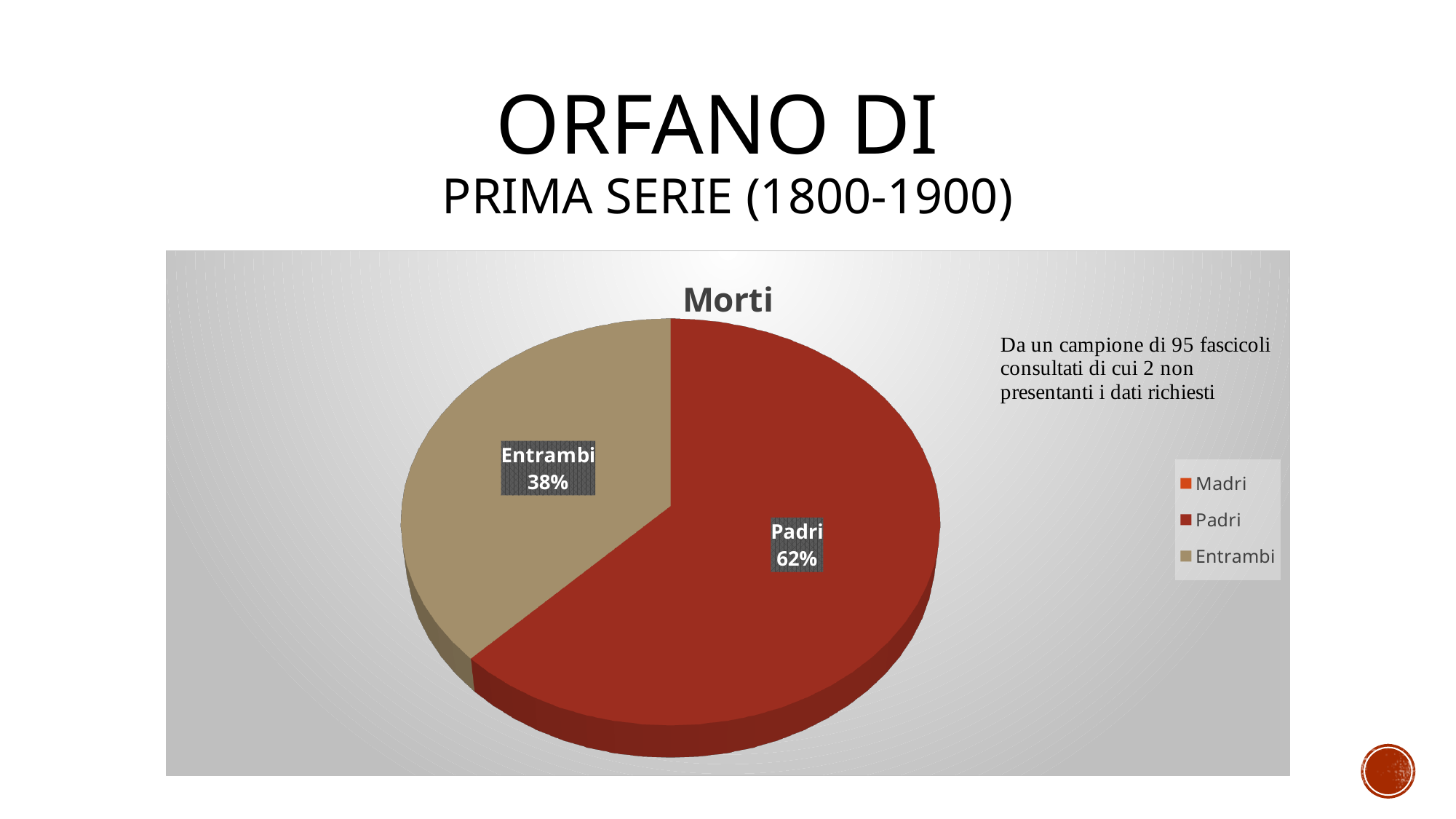
What share of the pie does Entrambi represent? 38% What share of the pie does Padri represent? 62% Which slice of the pie is the largest? Padri Which of the visible slices is the smallest? Entrambi Which legend entry has no visible slice in the pie? Madri What is the difference in percentage points between the Padri and Entrambi slices? 24 Is the share for Padri greater or less than 50%? greater What is the title of the chart? Morti How many slices are visible in the pie? 2 Which slice is larger, Padri or Entrambi? Padri How many entries does the legend list? 3 What kind of chart is shown on the slide? pie chart